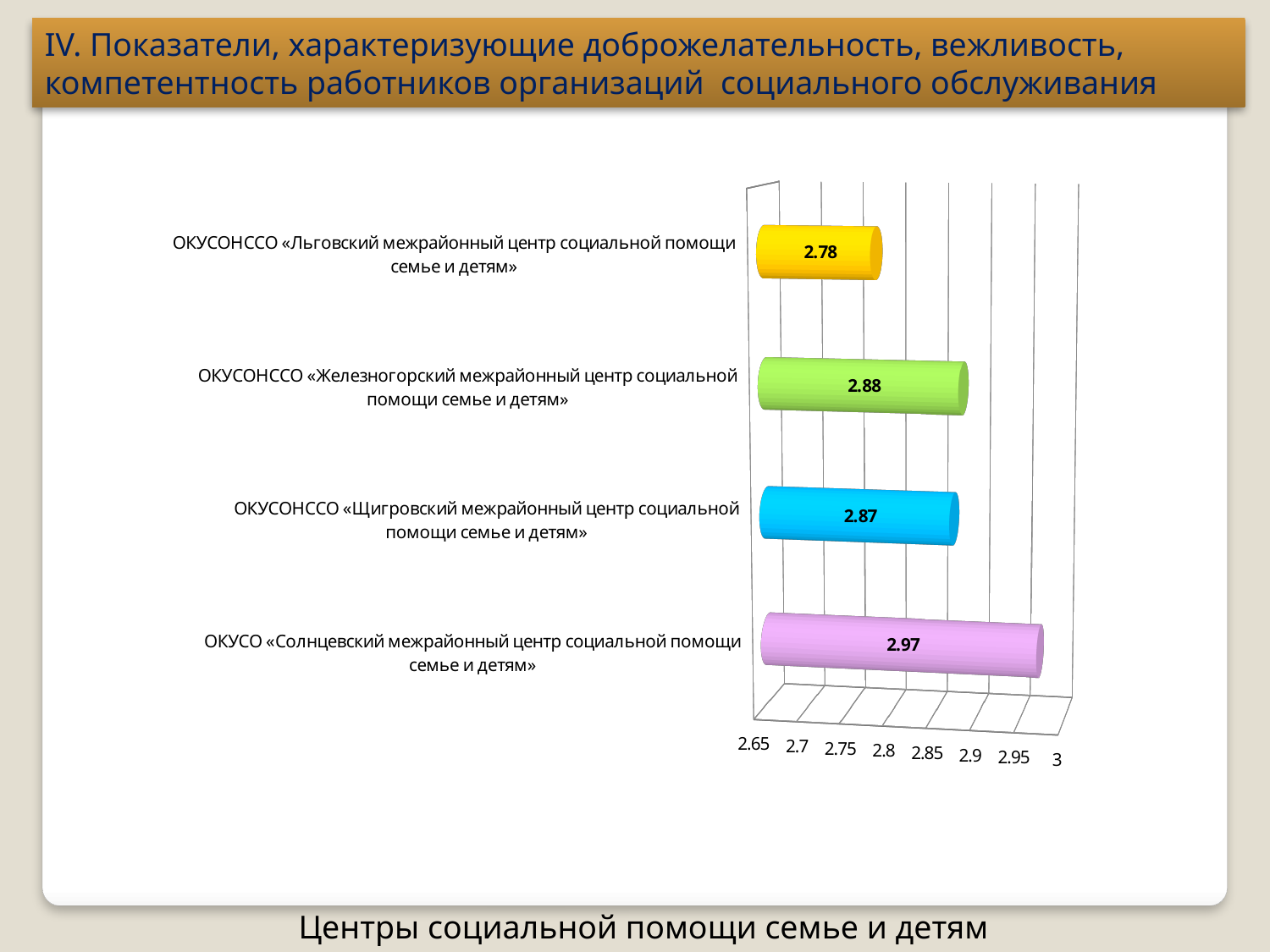
What is the value for ОКУСОНССО «Железногорский межрайонный центр социальной помощи семье и детям»? 2.88 What is the value for ОКУСОНССО «Льговский межрайонный центр социальной помощи семье и детям»? 2.78 What kind of chart is shown on the slide? bar chart How many organisations are shown on the chart? 4 Is the value for the Льговский centre greater or less than 2.8? less What is the value for ОКУСОНССО «Щигровский межрайонный центр социальной помощи семье и детям»? 2.87 What is the difference between the values for the Солнцевский centre and the Льговский centre? 0.19 Which organisation has the highest value on the chart? ОКУСО «Солнцевский межрайонный центр социальной помощи семье и детям» What is the difference between the values for the Железногорский centre and the Льговский centre? 0.1 Which organisation has the lowest value on the chart? ОКУСОНССО «Льговский межрайонный центр социальной помощи семье и детям» Which has a larger value, the Солнцевский centre or the Щигровский centre? ОКУСО «Солнцевский межрайонный центр социальной помощи семье и детям» What is the value for ОКУСО «Солнцевский межрайонный центр социальной помощи семье и детям»? 2.97